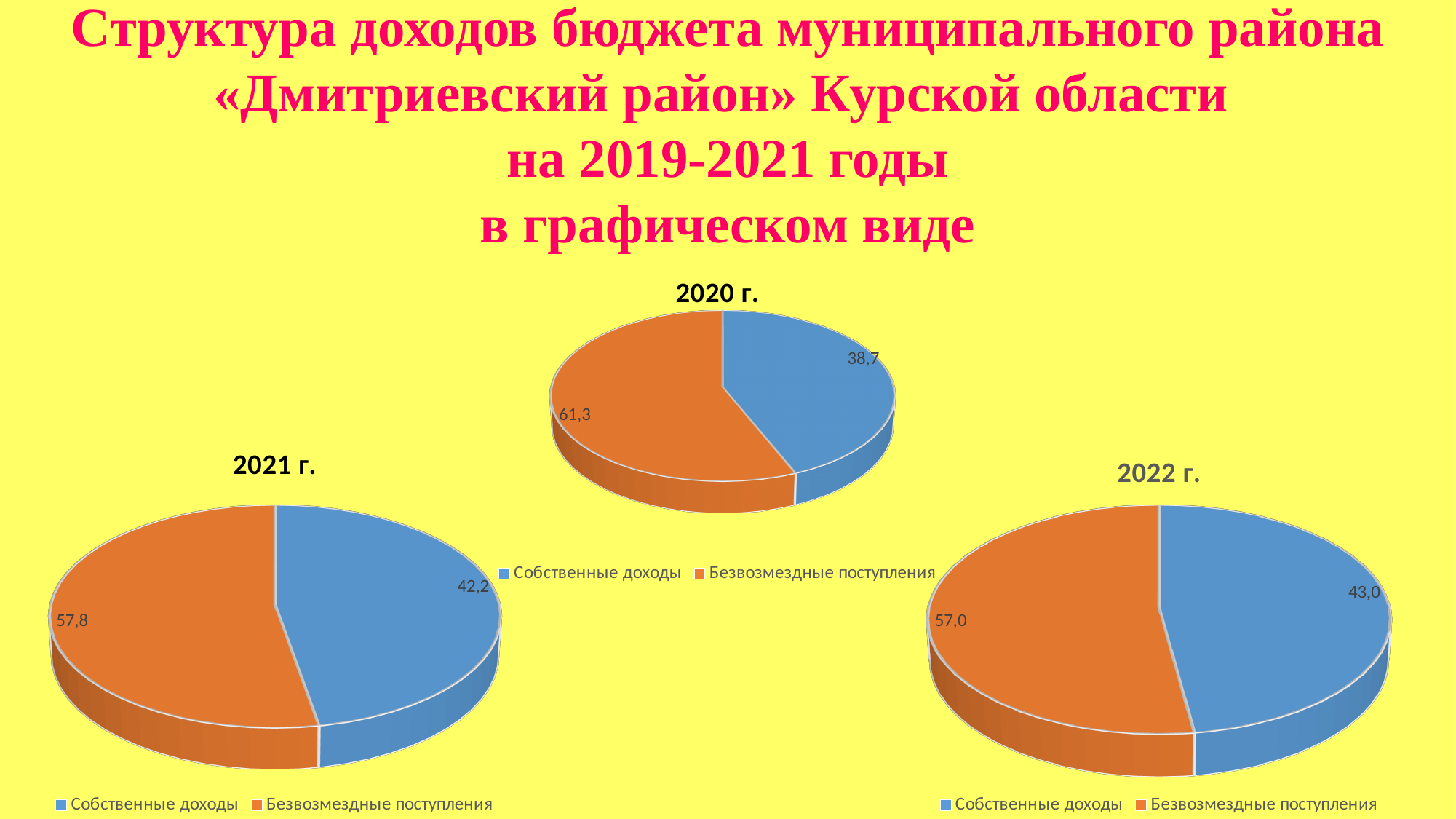
In the chart titled "2020 г.", what is the value for Собственные доходы? 38,7 How many slices does the chart titled "2020 г." have? 2 In the chart titled "2020 г.", what is the value for Безвозмездные поступления? 61,3 In the chart titled "2022 г.", which category has the smallest slice? Собственные доходы In the chart titled "2021 г.", which category has the largest slice? Безвозмездные поступления In the chart titled "2022 г.", what is the value for Безвозмездные поступления? 57,0 In the chart titled "2020 г.", what is the difference between Безвозмездные поступления and Собственные доходы? 22,6 What type of chart is the chart titled "2022 г."? Pie chart In the chart titled "2021 г.", which is larger: Собственные доходы or Безвозмездные поступления? Безвозмездные поступления In the chart titled "2021 г.", what colour is the Собственные доходы slice? Blue In the chart titled "2021 г.", what is the value for Собственные доходы? 42,2 In the chart titled "2022 г.", what is the difference between Безвозмездные поступления and Собственные доходы? 14,0